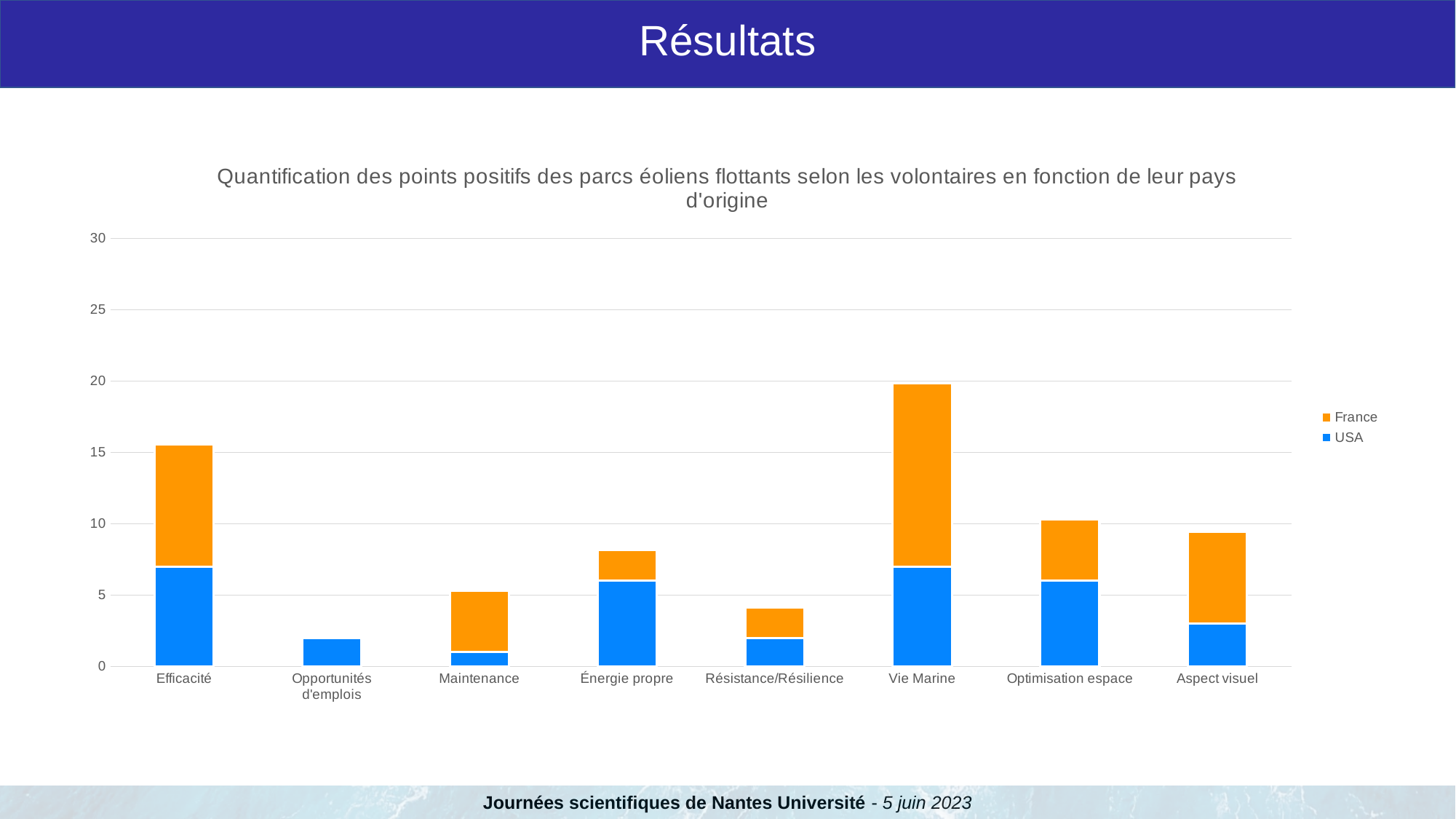
Is the total value for Vie Marine greater or less than 15? greater Is the total value for Opportunités d'emplois greater or less than 5? less How many categories are shown on the x axis of the chart? 8 Is the total value for Aspect visuel greater or less than 10? less Which has the larger total bar, Efficacité or Aspect visuel? Efficacité What kind of chart is shown on the slide? Stacked bar chart How many series does the chart legend list? 2 Which category has the lowest total bar in the chart? Opportunités d'emplois Which category has the largest France value? Vie Marine Which category has the highest total bar in the chart? Vie Marine Which colour represents the France series in the chart? Orange